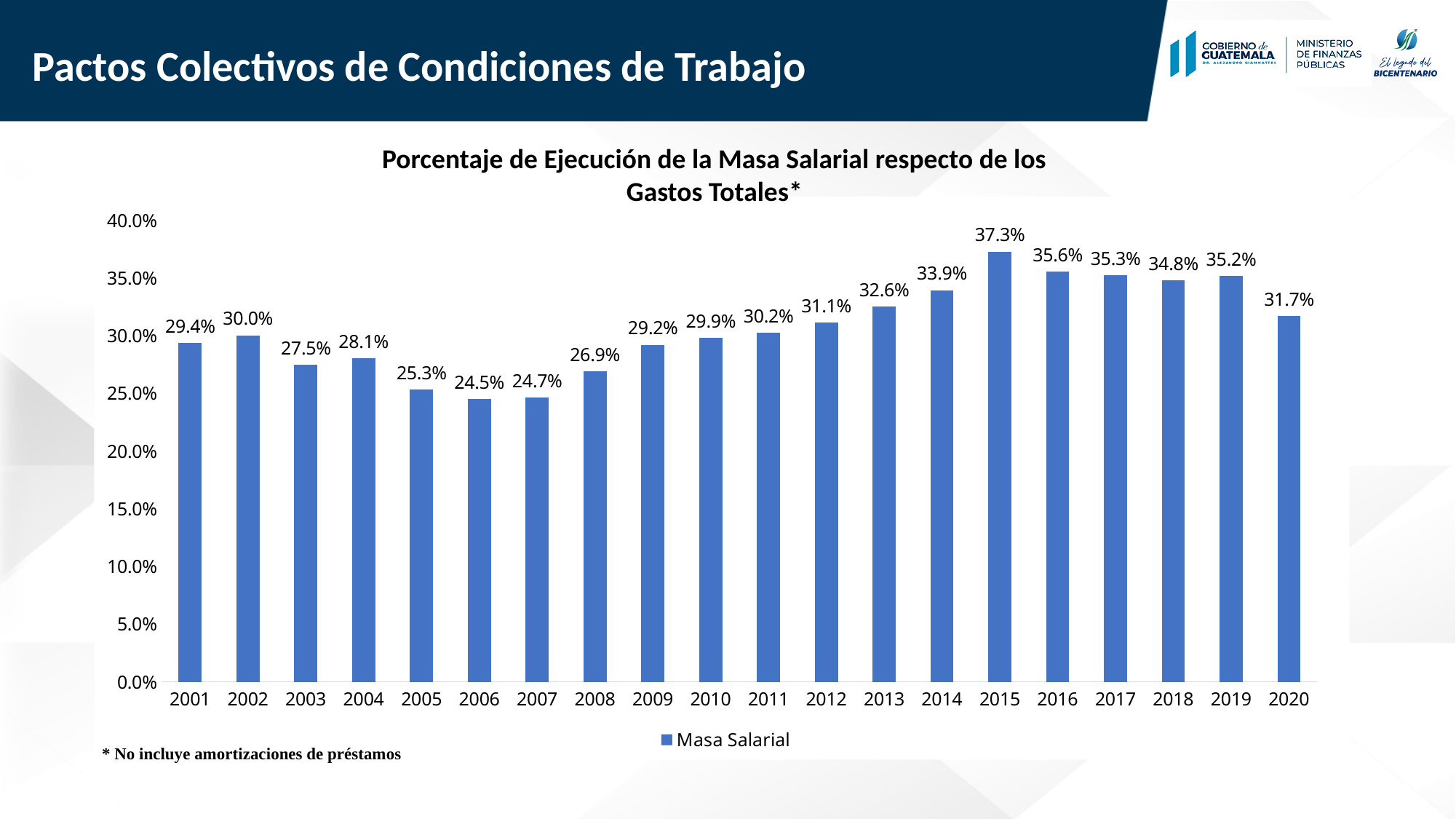
Is the value for 2013 greater or less than 30.0%? greater What is the value for 2015? 37.3% What is the value for 2006? 24.5% What kind of chart is shown? bar chart Which year has the lowest value? 2006 What is the difference between the values for 2015 and 2020? 5.6% What is the value for 2020? 31.7% How many years are shown on the x axis? 20 Which year has the highest value? 2015 What is the legend entry for the series? Masa Salarial Which is larger, the value for 2002 or the value for 2008? 2002 How many series does the legend list? 1